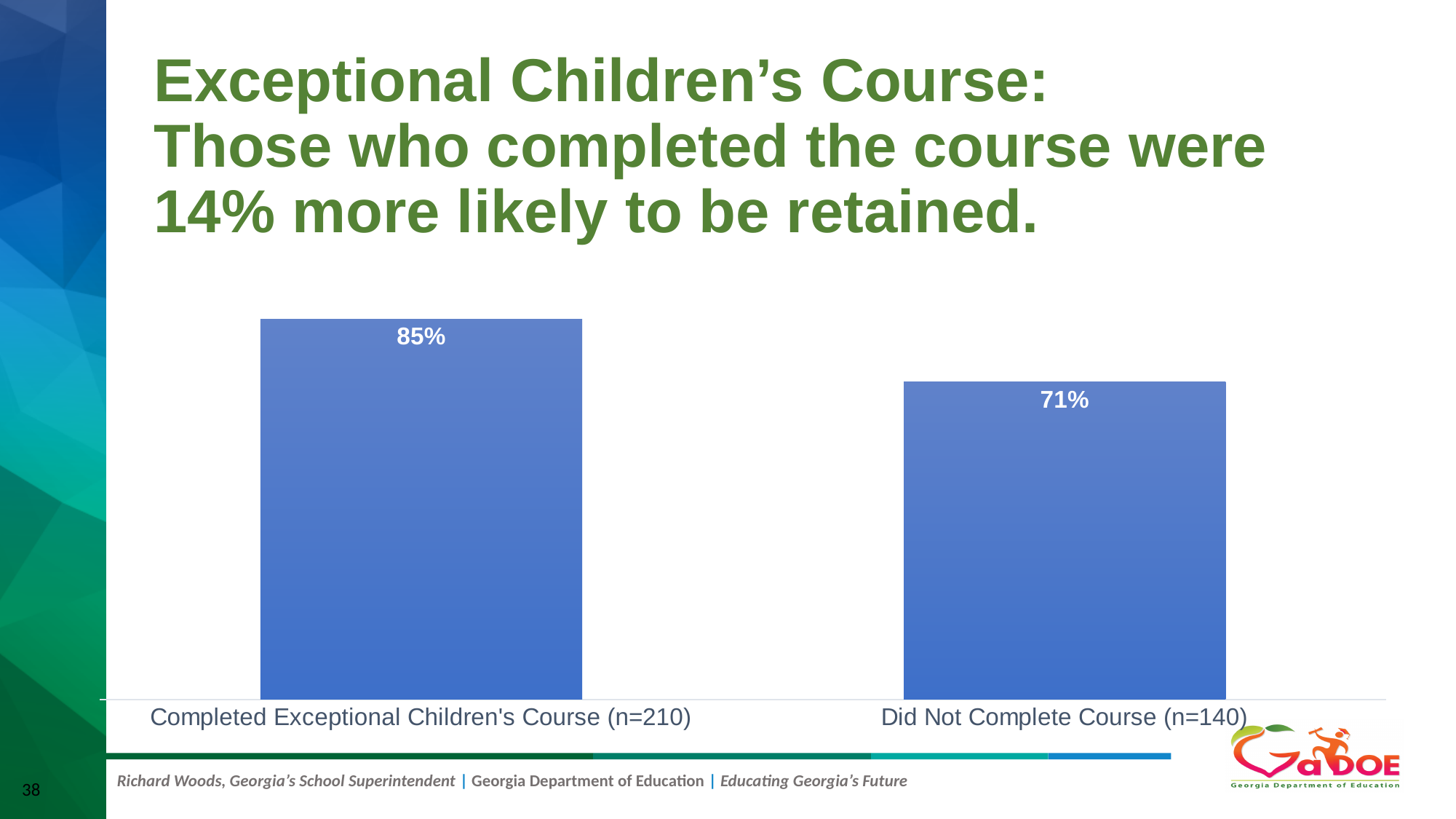
What is the difference between the value for Completed Exceptional Children's Course (n=210) and Did Not Complete Course (n=140)? 14% What is the value for Did Not Complete Course (n=140)? 71% What colour are the bars in the chart? Blue How many students completed the Exceptional Children's Course according to the category label? 210 Which category has the highest value? Completed Exceptional Children's Course (n=210) Which is larger: the value for Completed Exceptional Children's Course (n=210) or Did Not Complete Course (n=140)? Completed Exceptional Children's Course (n=210) How many categories are shown in the chart? 2 What kind of chart is shown on the slide? Bar chart What is the value for Completed Exceptional Children's Course (n=210)? 85% Which category has the lowest value? Did Not Complete Course (n=140)